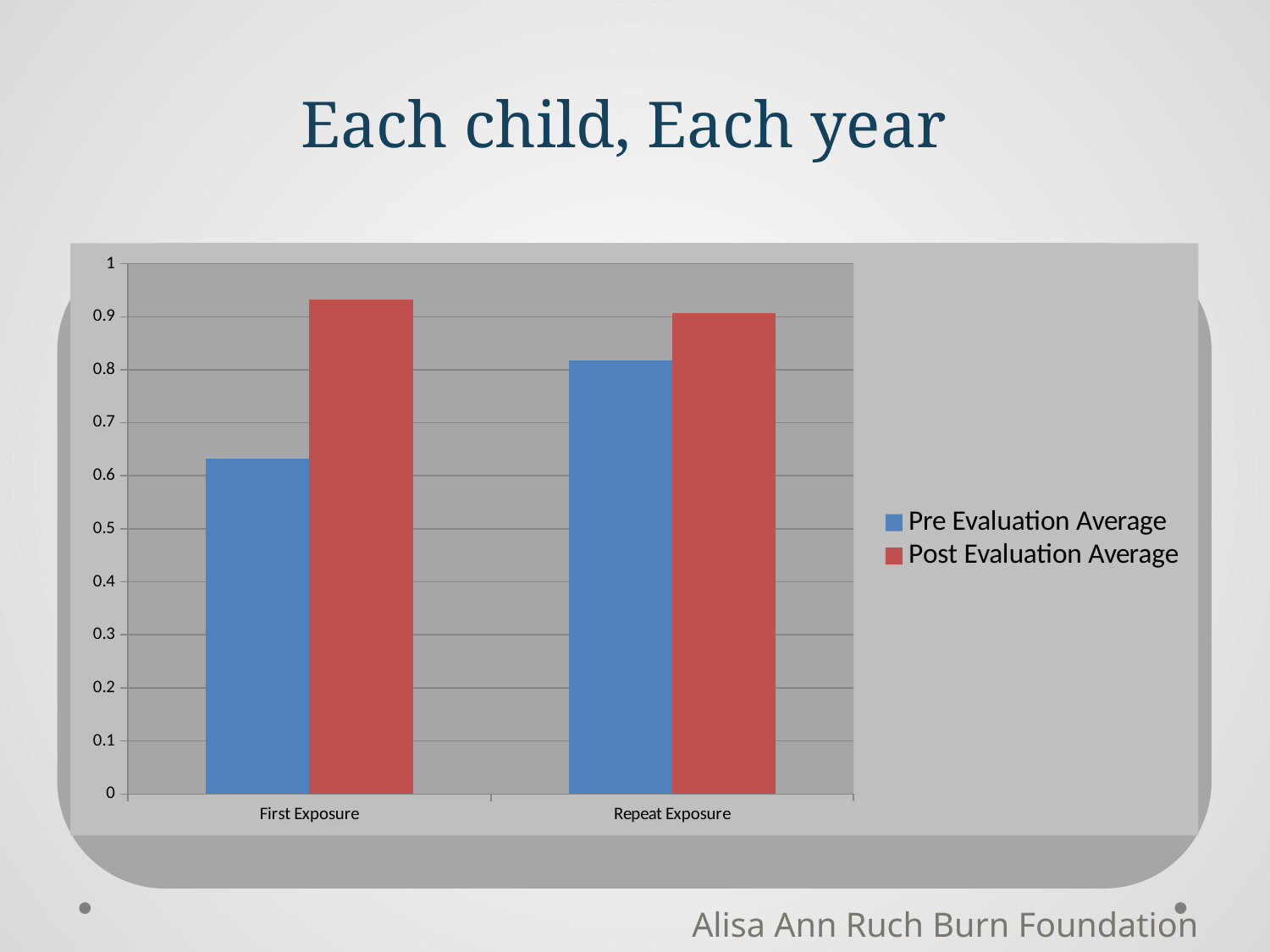
Which category has the larger Pre Evaluation Average, First Exposure or Repeat Exposure? Repeat Exposure Is the Pre Evaluation Average for First Exposure greater or less than 0.7? less How many categories are shown on the x axis? 2 How many series does the legend list? 2 For First Exposure, which is larger: the Pre Evaluation Average or the Post Evaluation Average? Post Evaluation Average What kind of chart is shown on the slide? bar chart What is the title of the slide containing the chart? Each child, Each year Is the Pre Evaluation Average for Repeat Exposure greater or less than 0.7? greater Is the Post Evaluation Average for First Exposure greater or less than 0.9? greater What are the two series named in the legend? Pre Evaluation Average and Post Evaluation Average Which bar is the lowest in the chart? Pre Evaluation Average for First Exposure